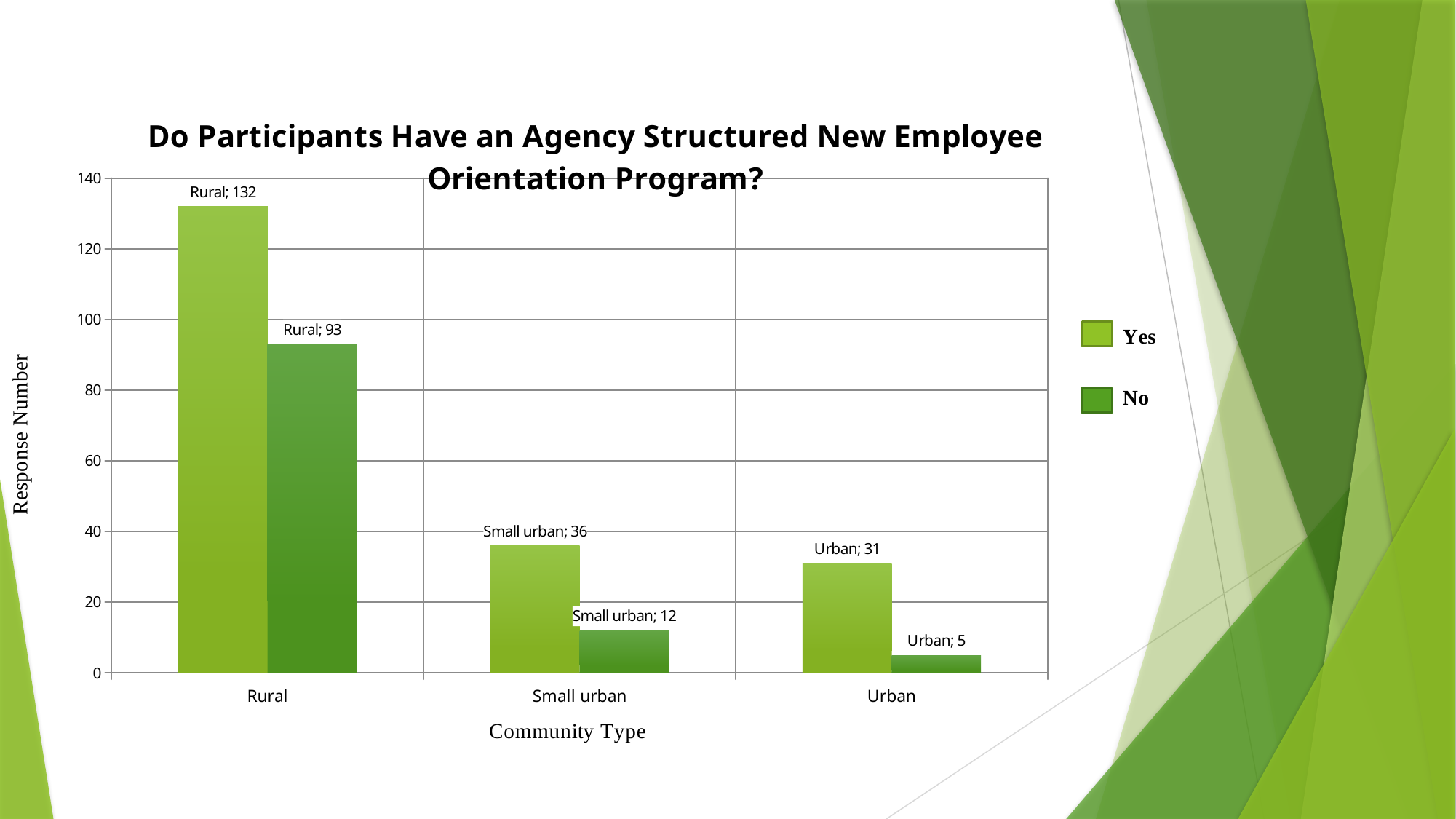
What is the difference between the 'Yes' and 'No' values for Rural? 39 How many series does the legend list? 2 What is the 'Yes' value for Urban? 31 What kind of chart is shown? bar chart Is the 'No' value for Rural greater or less than 100? less Which community type has the highest 'No' value? Rural How many community types are shown on the x axis? 3 What is the label of the y axis? Response Number Which is larger, the 'Yes' value for Small urban or the 'Yes' value for Urban? Small urban What is the 'Yes' value for Rural? 132 Which community type has the lowest 'Yes' value? Urban What is the 'No' value for Small urban? 12